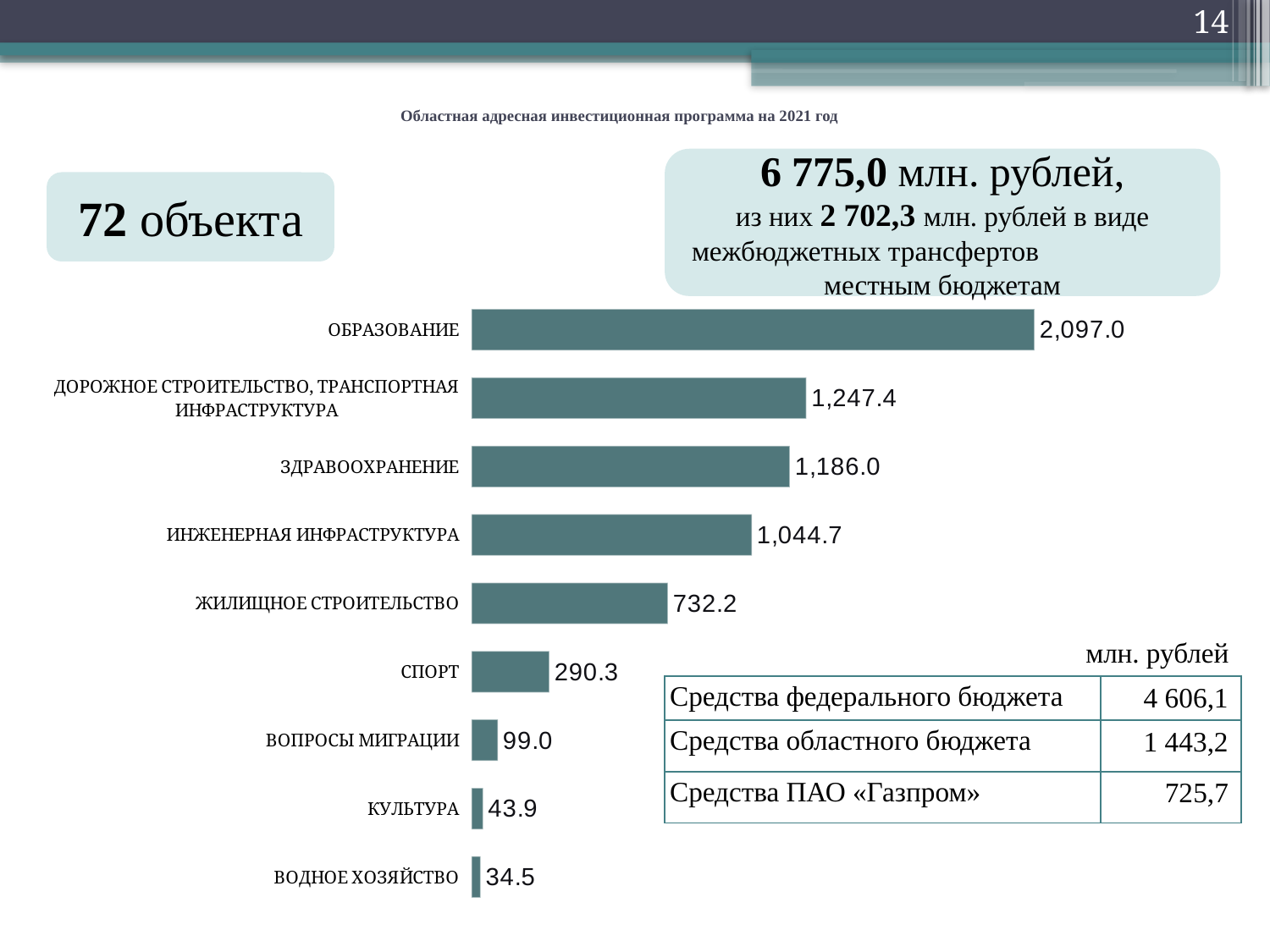
What is the difference between the values for ОБРАЗОВАНИЕ and ДОРОЖНОЕ СТРОИТЕЛЬСТВО, ТРАНСПОРТНАЯ ИНФРАСТРУКТУРА? 849.6 What is the value for ЖИЛИЩНОЕ СТРОИТЕЛЬСТВО? 732.2 What is the value for ЗДРАВООХРАНЕНИЕ? 1,186.0 Which is larger, the value for СПОРТ or the value for ВОПРОСЫ МИГРАЦИИ? СПОРТ Which category has the lowest value? ВОДНОЕ ХОЗЯЙСТВО What kind of chart is shown on the slide? bar chart What is the value for КУЛЬТУРА? 43.9 Which is larger, the value for ЗДРАВООХРАНЕНИЕ or the value for ДОРОЖНОЕ СТРОИТЕЛЬСТВО, ТРАНСПОРТНАЯ ИНФРАСТРУКТУРА? ДОРОЖНОЕ СТРОИТЕЛЬСТВО, ТРАНСПОРТНАЯ ИНФРАСТРУКТУРА Which category has the highest value? ОБРАЗОВАНИЕ How many categories does the chart show? 9 What is the value for ОБРАЗОВАНИЕ? 2,097.0 What is the difference between the values for ЗДРАВООХРАНЕНИЕ and ИНЖЕНЕРНАЯ ИНФРАСТРУКТУРА? 141.3